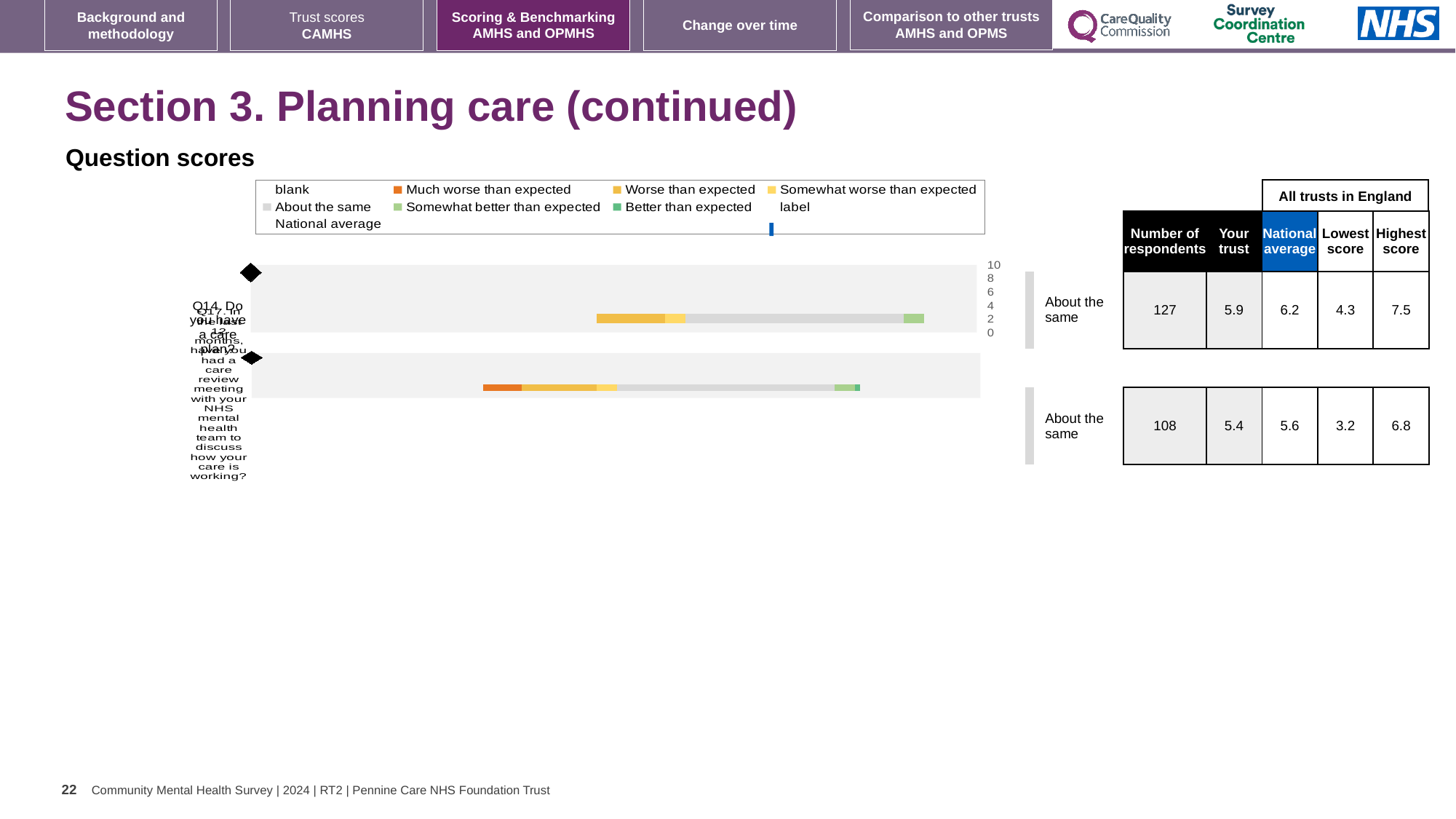
In the table beside the chart, which question has the higher 'Your trust' score, Q14 or Q17? Q14 In the table beside the chart, what is the difference between the highest score and the lowest score for Q14? 3.2 In the table beside the chart, how many respondents answered Q17? 108 How many questions (bars) are plotted in the chart? 2 What kind of chart is shown under 'Question scores'? bar chart What is the highest value shown on the chart's axis? 10 What is the benchmark category shown next to the bar for Q14? About the same In the table beside the chart, what is the national average for Q14? 6.2 In the table beside the chart, what is the 'Your trust' score for Q14? 5.9 In the table beside the chart, what is the 'Your trust' score for Q17? 5.4 What colour does the legend use for 'Much worse than expected'? orange What is the benchmark category shown next to the bar for Q17? About the same